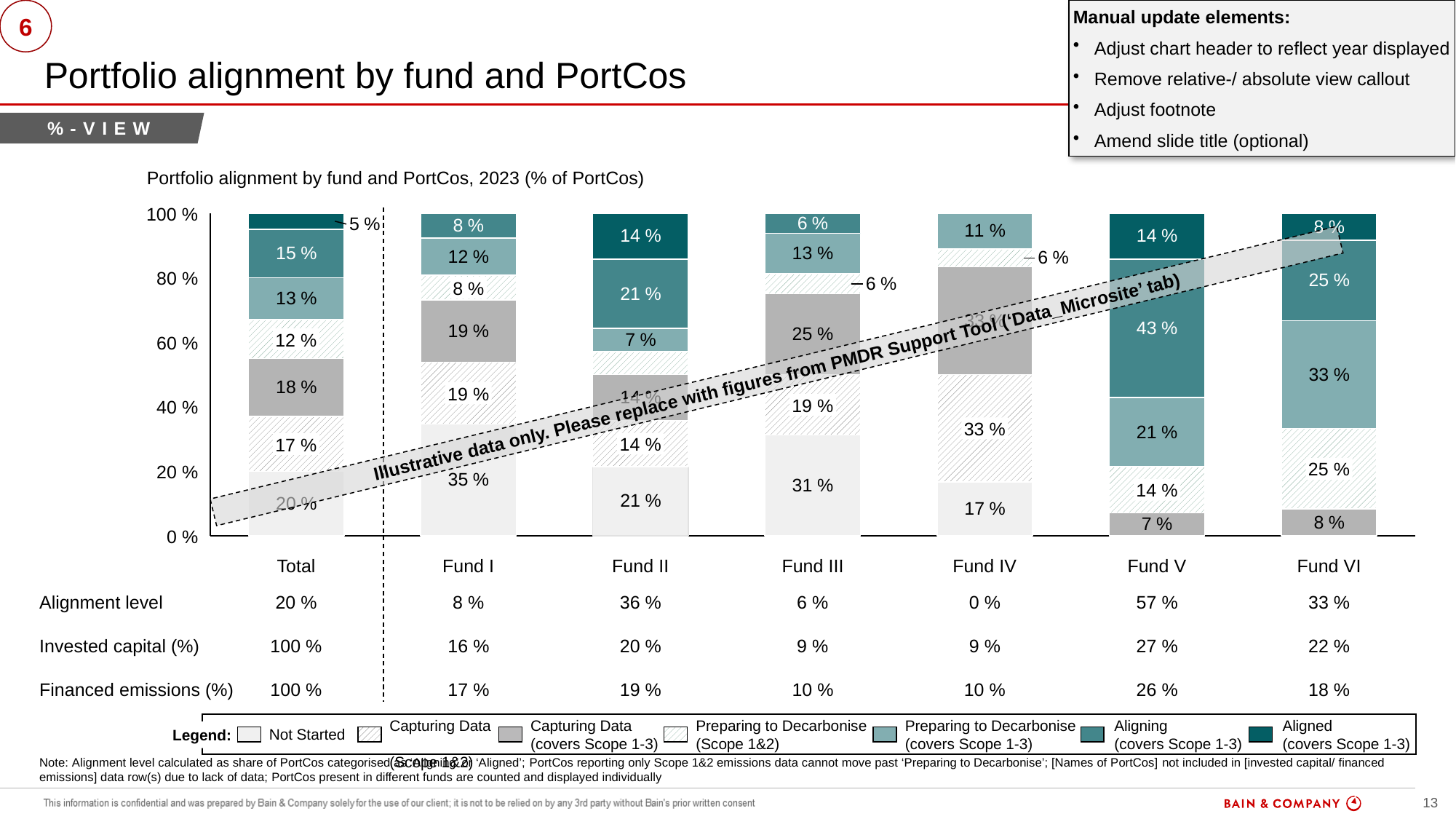
What is the value of the 'Aligned (covers Scope 1-3)' segment for Fund II? 14 % What is the value of the 'Not Started' segment for Fund III? 31 % What is the title of the chart? Portfolio alignment by fund and PortCos, 2023 (% of PortCos) What is the value of the 'Not Started' segment for Fund I? 35 % Which fund has the largest 'Not Started' segment? Fund I What kind of chart is shown on the slide? Stacked bar chart What is the value of the 'Aligning (covers Scope 1-3)' segment for the Total bar? 15 % Which is larger: the 'Aligning (covers Scope 1-3)' segment for Fund II or for Fund VI? Fund VI How many series does the chart legend list? 7 What is the difference between the 'Aligning (covers Scope 1-3)' segment for Fund V and for Fund VI? 18 % How many categories (bars) are shown along the x axis of the chart? 7 What is the value of the 'Aligning (covers Scope 1-3)' segment for Fund V? 43 %